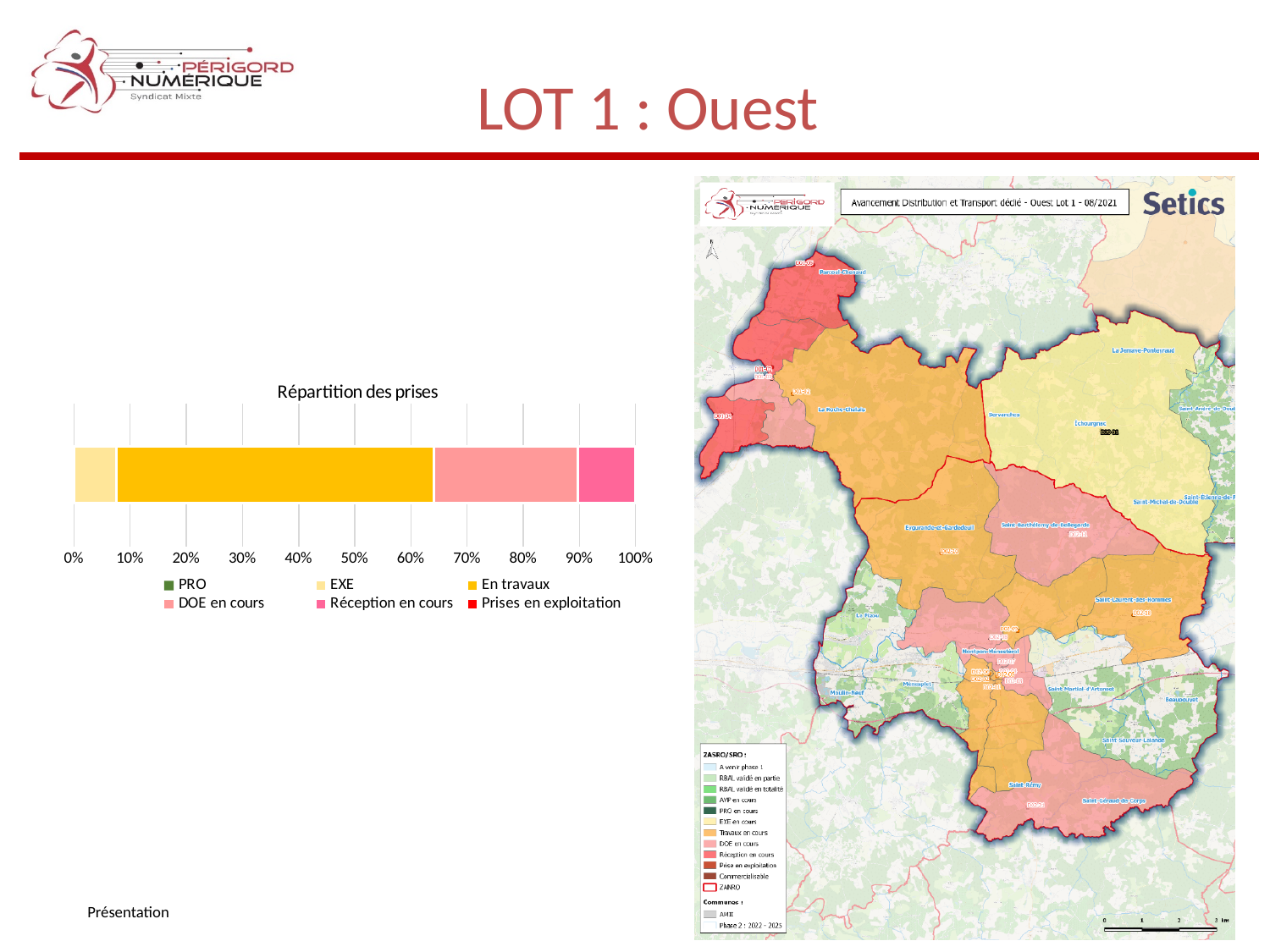
What is the title of the chart on the left of the slide? Répartition des prises In "Répartition des prises", is the share for DOE en cours greater or less than 30%? less In "Répartition des prises", is the share for Réception en cours greater or less than 20%? less What is the highest value shown on the x axis of "Répartition des prises"? 100% In "Répartition des prises", which is larger: the share for En travaux or the share for DOE en cours? En travaux In "Répartition des prises", is the share for DOE en cours greater or less than 20%? greater In "Répartition des prises", which series occupies the largest share of the bar? En travaux How many series does the legend of "Répartition des prises" list? 6 What kind of chart is "Répartition des prises"? bar chart In "Répartition des prises", which is larger: the share for EXE or the share for DOE en cours? DOE en cours